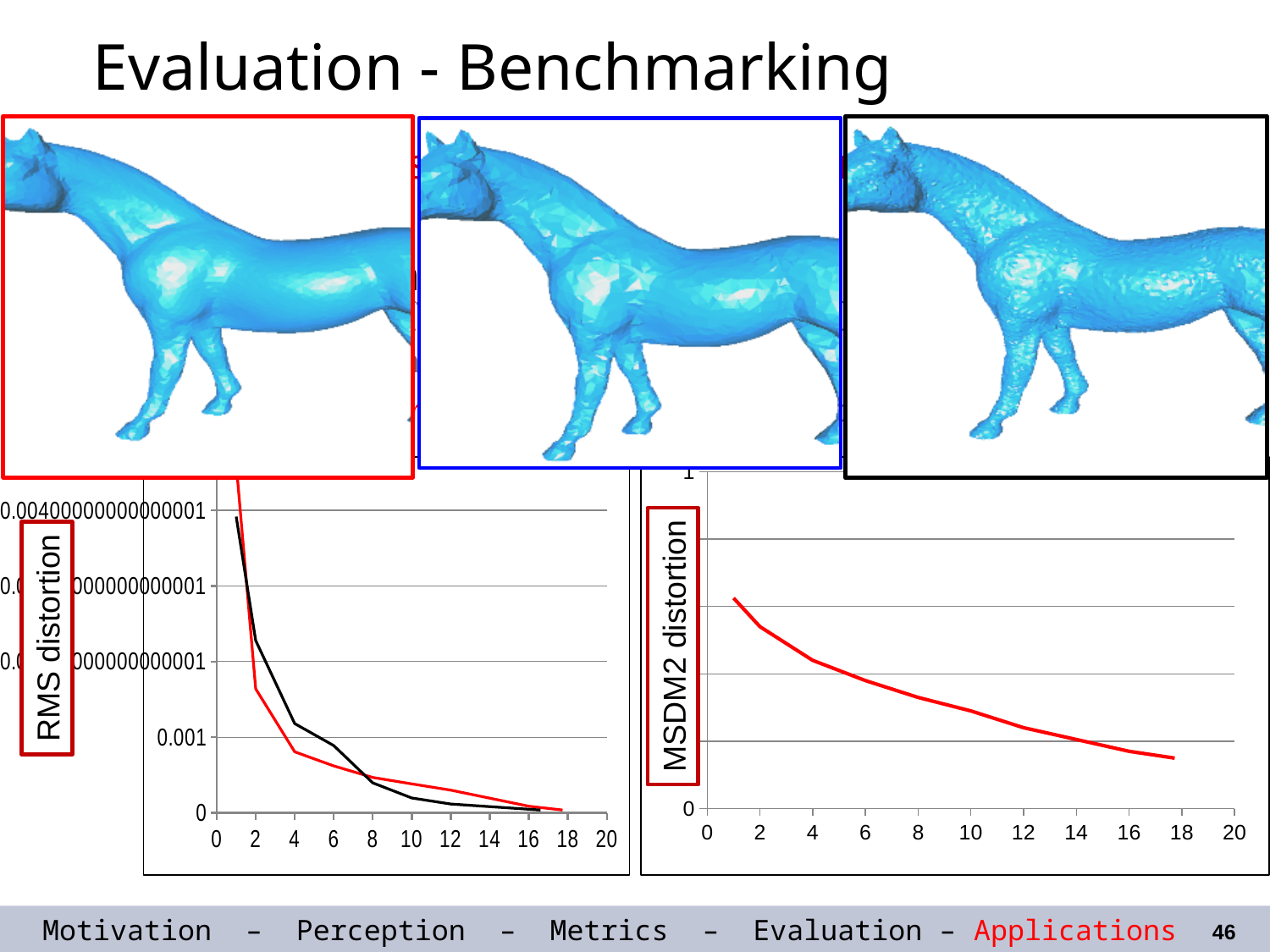
How many lines are plotted in the left chart (RMS distortion)? 2 In the left chart (RMS distortion), is the value of the red line at x = 4 greater or less than 0.001? less In the left chart (RMS distortion), is the value of the black line at x = 2 greater or less than 0.002? greater In the right chart (MSDM2 distortion), do the values rise or fall as the x axis increases? fall In the right chart (MSDM2 distortion), is the value of the red line at x = 2 greater or less than 1? less In the left chart (RMS distortion), which line is higher at x = 12, the red line or the black line? red line What kind of chart is the left chart labelled RMS distortion? line chart In the left chart (RMS distortion), which line is higher at x = 2, the red line or the black line? black line What kind of chart is the right chart labelled MSDM2 distortion? line chart In the left chart (RMS distortion), do the values rise or fall as the x axis increases? fall What is the y-axis label of the right chart? MSDM2 distortion